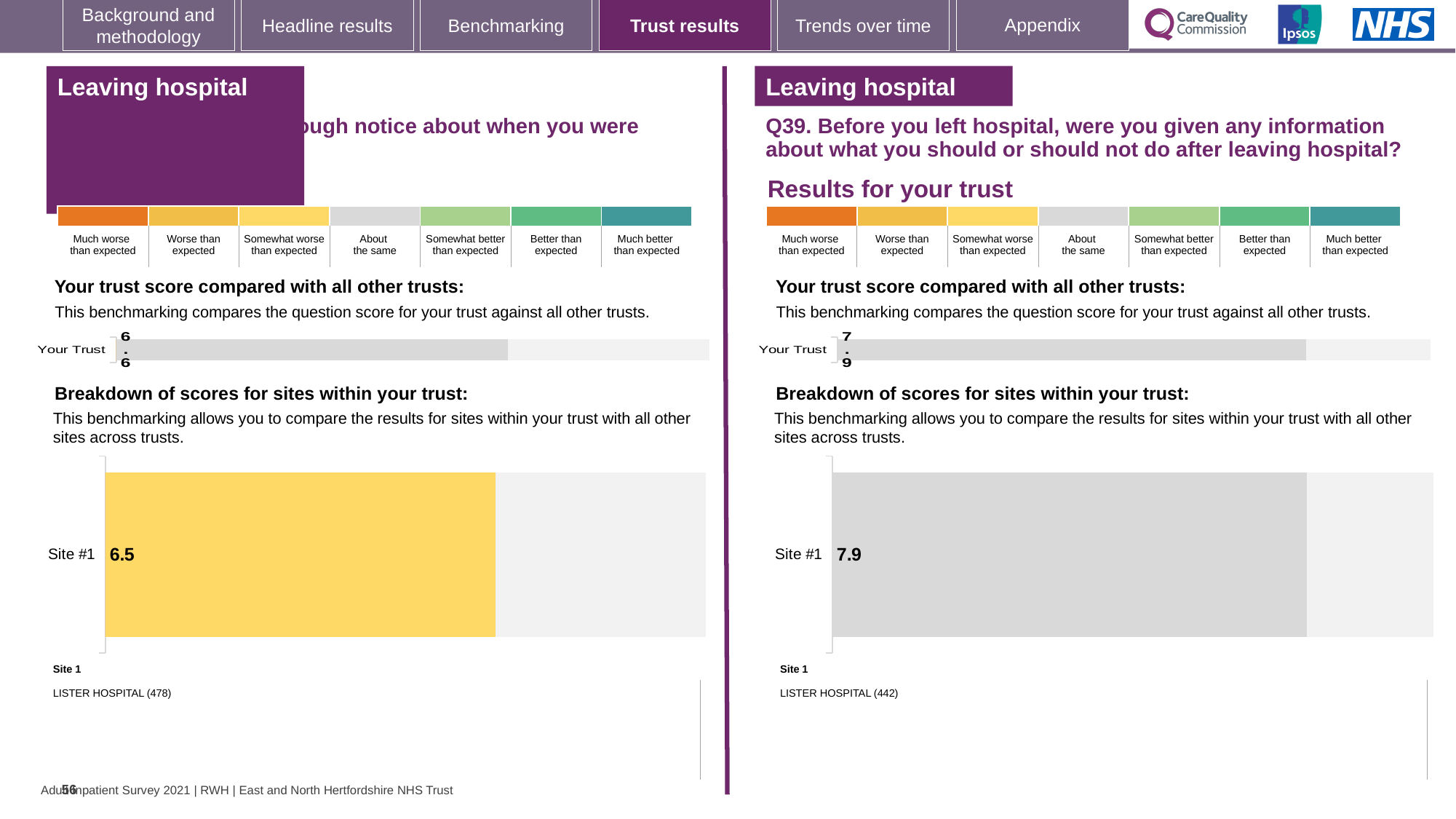
On the breakdown chart on the left half of the slide, what is the score for Site #1? 6.5 Which Site #1 score is larger: the one on the left half of the slide or the one on the Q39 chart on the right half? The Q39 chart on the right half On the left half of the slide, what is the difference between the Your Trust score and the Site #1 score? 0.1 What is the difference between the Site #1 score on the Q39 chart (right half) and the Site #1 score on the left half of the slide? 1.4 How many sites are shown in the breakdown chart on the Q39 chart on the right half of the slide? 1 On the Q39 breakdown chart on the right half of the slide, which benchmark category does the grey colour of the Site #1 bar correspond to? About the same On the breakdown chart on the left half of the slide, what colour is the Site #1 bar? Yellow On the trust score chart on the left half of the slide, what is the score shown for Your Trust? 6.6 On the Q39 chart on the right half of the slide, how many respondents are listed for Site 1, Lister Hospital? 442 On the Q39 chart on the right half of the slide, what is the score shown for Your Trust? 7.9 On the Q39 breakdown chart on the right half of the slide, what is the score for Site #1? 7.9 What type of chart is used to show the Site #1 score on the Q39 chart on the right half of the slide? Bar chart